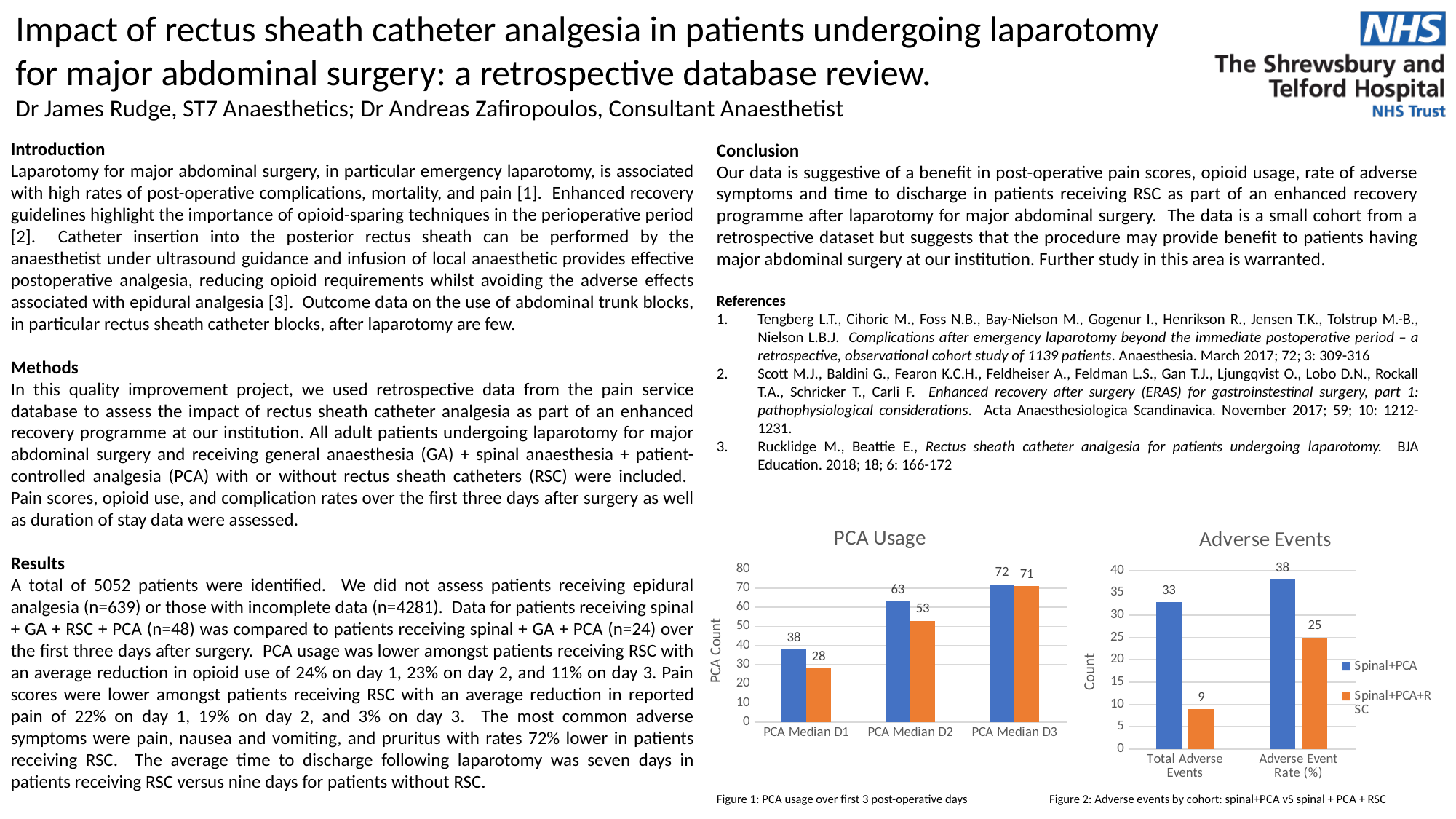
In the PCA Usage chart, what is the value of the blue bar for PCA Median D1? 38 In the PCA Usage chart, what is the difference between the blue and orange bars for PCA Median D3? 1 How many categories are shown on the x axis of the PCA Usage chart? 3 What type of chart is the Adverse Events chart? bar chart In the Adverse Events chart, which series has the larger Adverse Event Rate (%), Spinal+PCA or Spinal+PCA+RSC? Spinal+PCA How many series does the legend of the Adverse Events chart list? 2 In the PCA Usage chart, which category has the highest blue bar? PCA Median D3 In the Adverse Events chart, what is the Adverse Event Rate (%) for Spinal+PCA? 38 In the PCA Usage chart, what is the value of the orange bar for PCA Median D2? 53 In the Adverse Events chart, what is the value for Spinal+PCA+RSC for Total Adverse Events? 9 In the Adverse Events chart, what is the difference between Spinal+PCA and Spinal+PCA+RSC for Total Adverse Events? 24 In the PCA Usage chart, do the orange bar values rise or fall from PCA Median D1 to PCA Median D3? rise